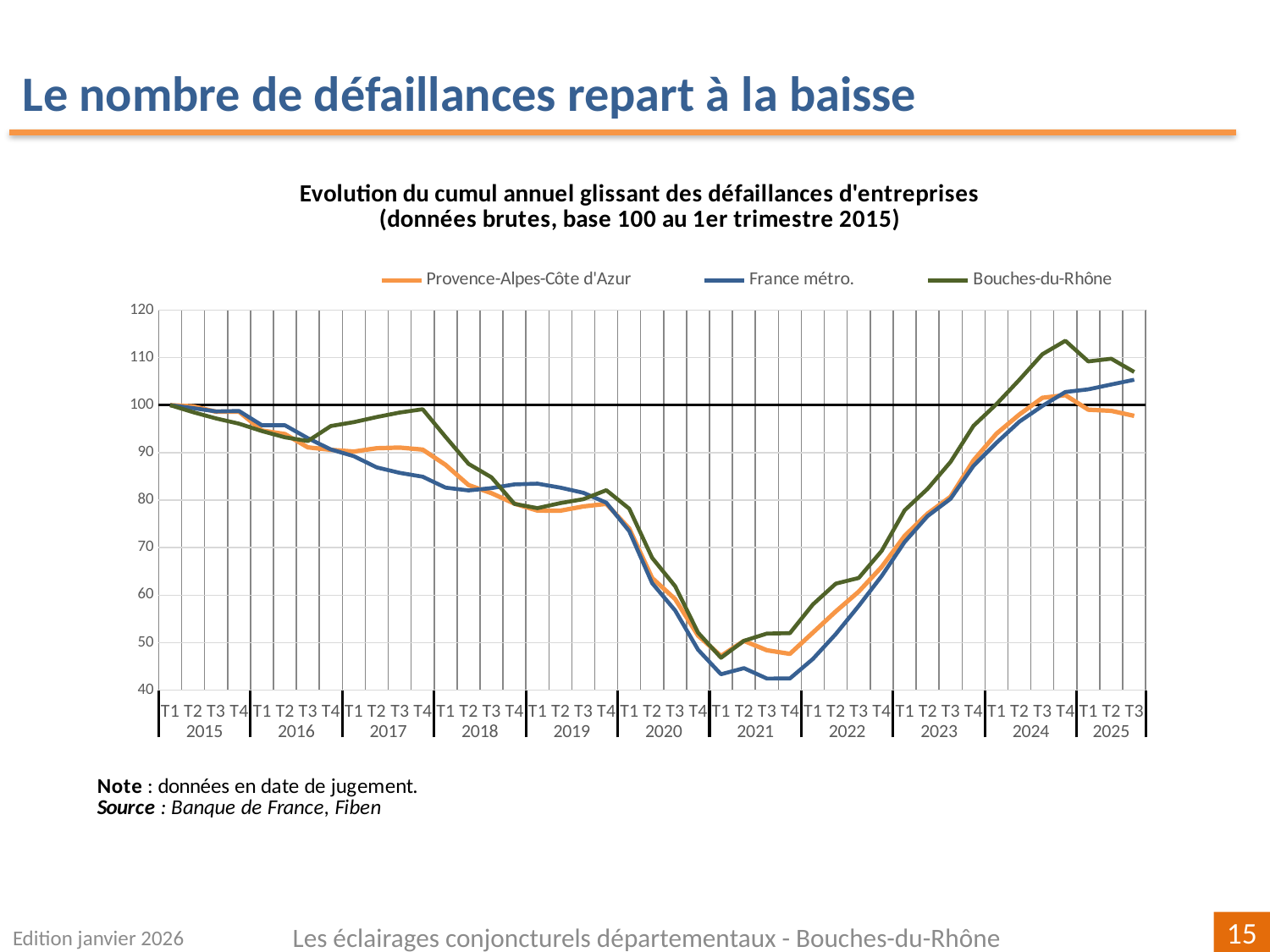
Which series has the lowest value at T3 2025? Provence-Alpes-Côte d'Azur Is the value for Bouches-du-Rhône at T4 2024 greater or less than 110? greater Is the value for Bouches-du-Rhône at T3 2025 greater or less than 100? greater How many series does the legend list? 3 Is the value for Provence-Alpes-Côte d'Azur at T3 2025 greater or less than 100? less Which series is plotted in green? Bouches-du-Rhône How many years are labelled on the x axis? 11 What kind of chart is shown on the slide? Line chart Do the values for France métro. rise or fall between T1 2015 and T1 2021? fall What is the value of each series at T1 2015, the base period? 100 Which series has the highest value at T3 2025? Bouches-du-Rhône